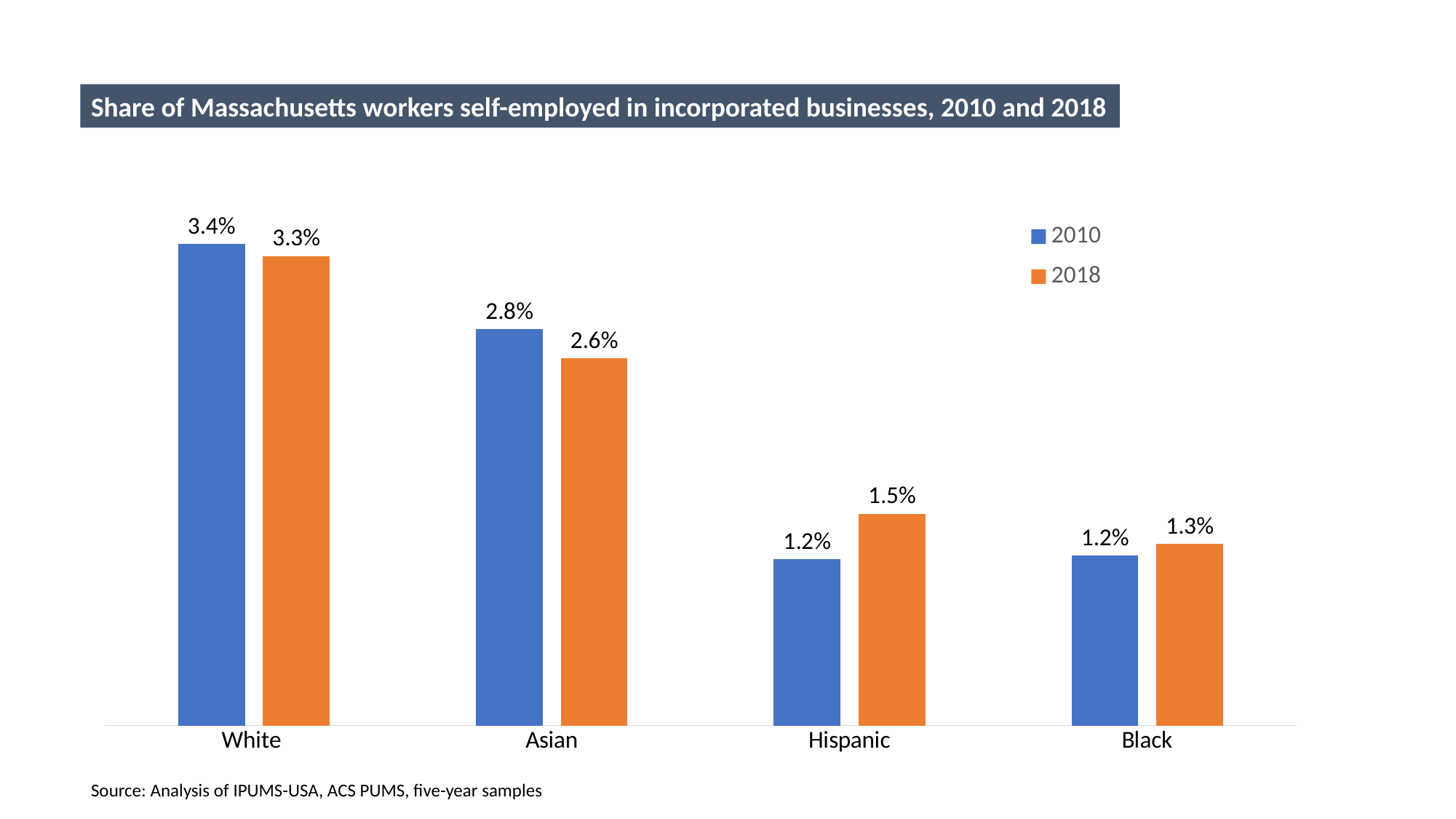
By how many percentage points did the share for Asian workers change from 2010 to 2018? 0.2 percentage points lower What was the share of Black workers self-employed in incorporated businesses in 2010? 1.2% Which group had the lowest share of workers self-employed in incorporated businesses in 2018? Black How many series does the legend list? 2 Which colour represents the 2018 series in the chart? Orange What was the share of White Massachusetts workers self-employed in incorporated businesses in 2010? 3.4% Which is larger: the 2018 share for Hispanic workers or the 2018 share for Black workers? Hispanic What was the share of Hispanic workers self-employed in incorporated businesses in 2018? 1.5% What was the share of Asian workers self-employed in incorporated businesses in 2018? 2.6% Which group had the highest share of workers self-employed in incorporated businesses in 2018? White How many racial/ethnic groups are shown on the x axis? 4 What kind of chart is shown on the slide? Bar chart